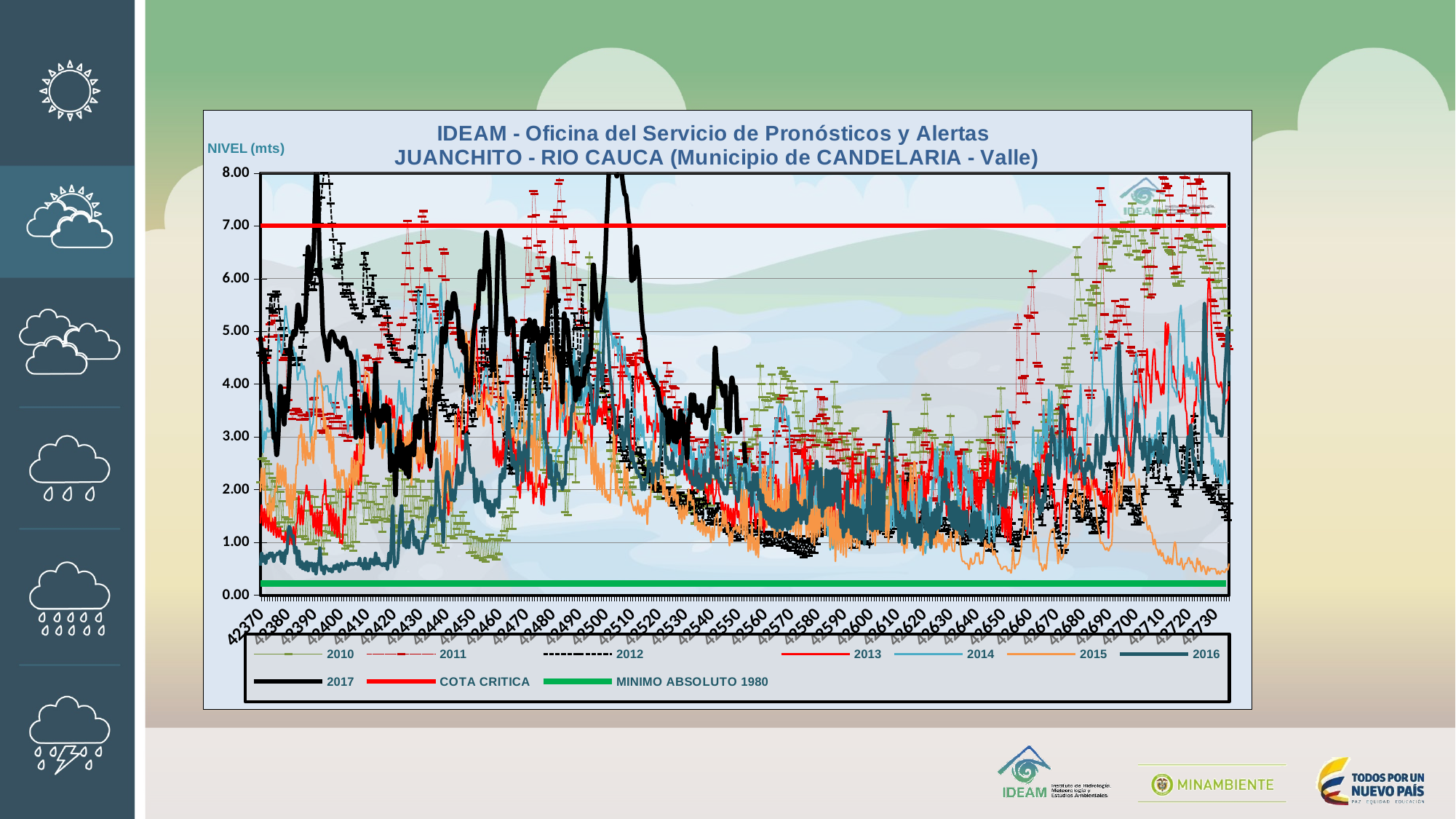
What is the highest value shown on the vertical axis? 8.00 What is the label of the vertical axis? NIVEL (mts) What kind of chart is shown on the slide? line chart Is the 2016 series value at 42400 greater or less than 1.00? less Which station and river does the chart title name? JUANCHITO - RIO CAUCA (Municipio de CANDELARIA - Valle) Is the 2015 series value at 42720 greater or less than 1.00? less How many series does the legend list? 10 Which line is higher, COTA CRITICA or MINIMO ABSOLUTO 1980? COTA CRITICA At what level (mts) is the COTA CRITICA line drawn? 7.00 Is the MINIMO ABSOLUTO 1980 line greater or less than 1.00? less